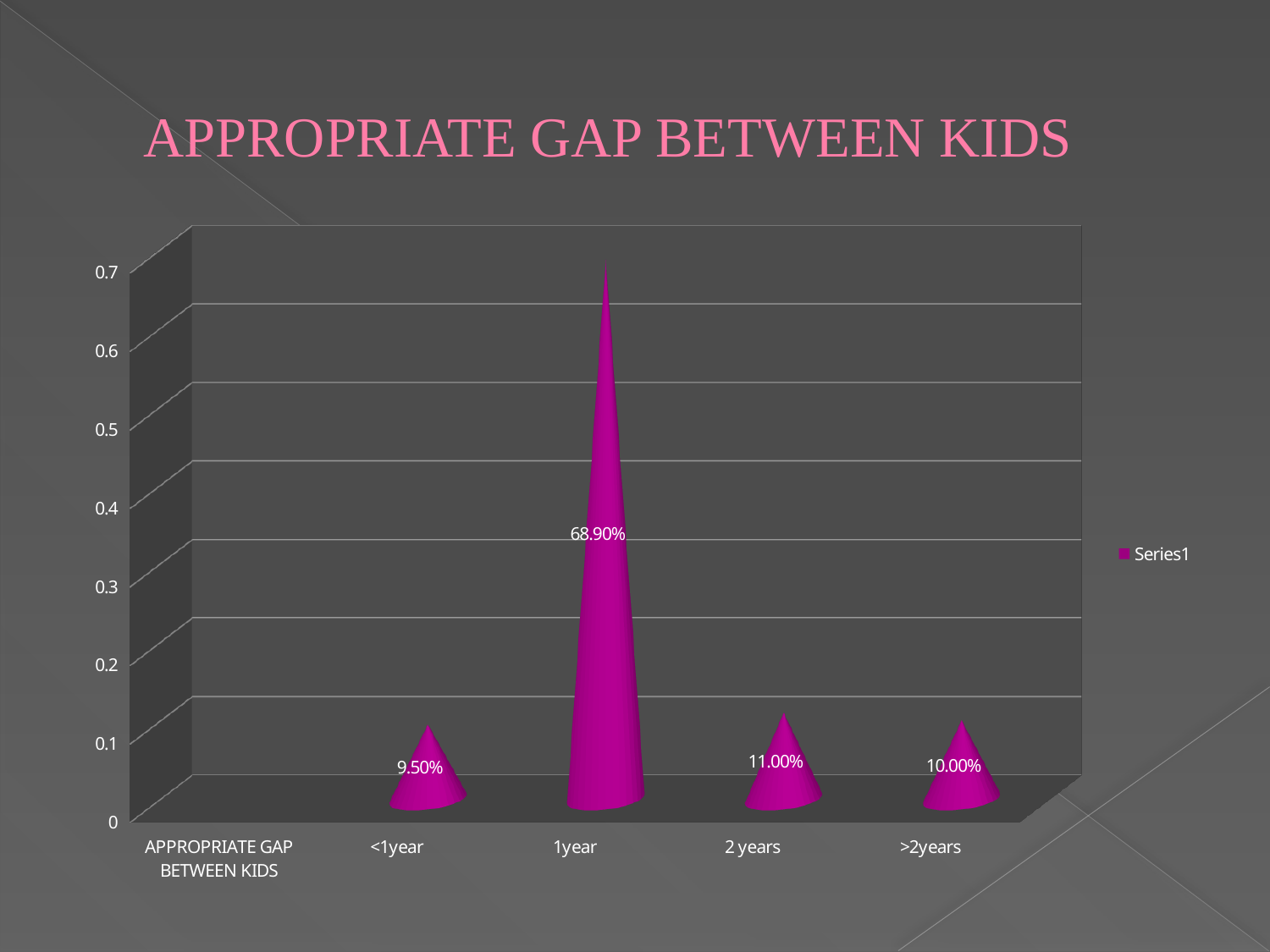
Which is larger, the value for 2 years or the value for >2years? 2 years How many series does the legend list? 1 Is the value for 1year greater or less than 0.5? greater What is the value for >2years? 10.00% What is the value for 2 years? 11.00% What is the value for <1year? 9.50% What kind of chart is shown on the slide? bar chart Which category has the highest value? 1year How many bars are plotted in the chart? 4 What is the value for 1year? 68.90% What is the difference between the values for 1year and <1year? 59.40% Which category has the lowest value? <1year